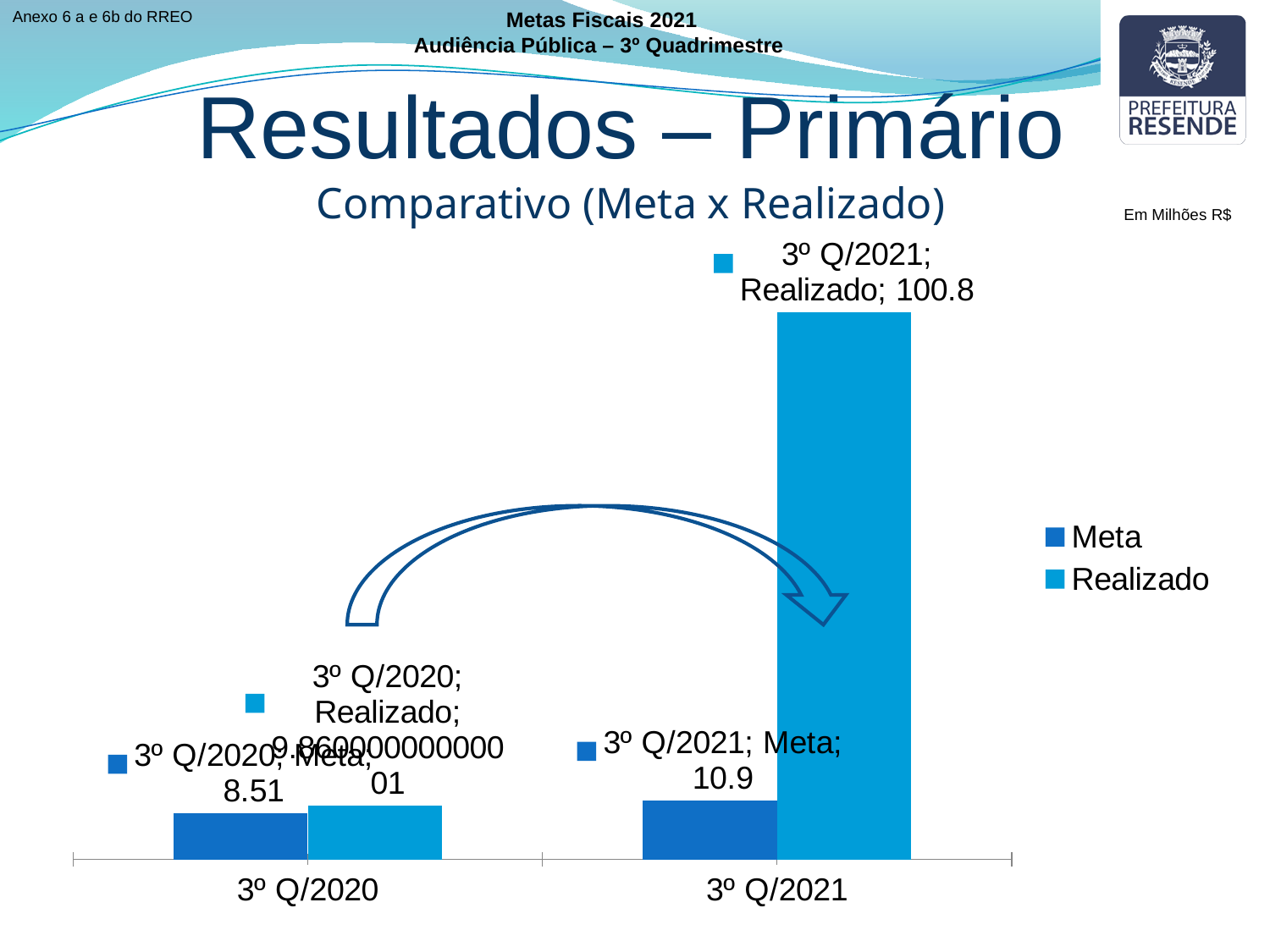
How many series does the legend list? 2 What is the Meta value for 3º Q/2021? 10.9 What is the Realizado value for 3º Q/2021? 100.8 Which bar is the highest in the chart? Realizado for 3º Q/2021 Which period has the larger Meta value, 3º Q/2020 or 3º Q/2021? 3º Q/2021 What is the difference between the Realizado and Meta values for 3º Q/2021? 89.9 What is the Meta value for 3º Q/2020? 8.51 What unit is stated for the values in the chart? Em Milhões R$ Which bar is the lowest in the chart? Meta for 3º Q/2020 What is the difference between the Meta values for 3º Q/2021 and 3º Q/2020? 2.39 How many periods (categories) are shown on the x axis? 2 What kind of chart is shown on the slide? Bar chart